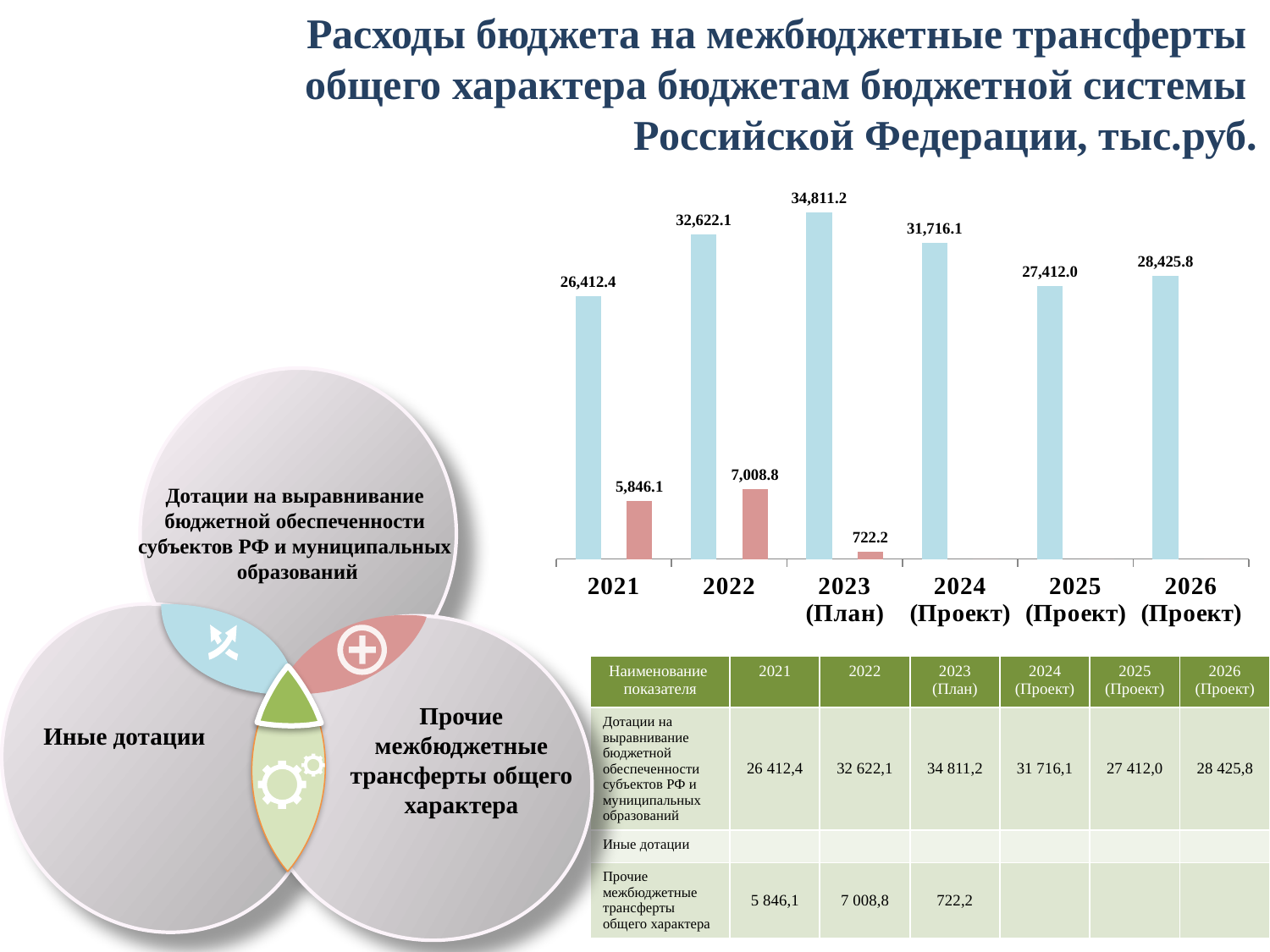
What is the difference between the pink bar values for 2022 and 2021? 1,162.7 What is the value of the pink bar for 2022? 7,008.8 What is the value of the pink bar for 2023 (План)? 722.2 What is the value of the light blue bar for 2023 (План)? 34,811.2 How many year categories are shown on the x axis of the chart? 6 In which year is the light blue bar the lowest? 2021 What is the value of the light blue bar for 2026 (Проект)? 28,425.8 Do the pink bar values rise or fall from 2022 to 2023 (План)? Fall Which is larger: the light blue bar for 2025 (Проект) or for 2026 (Проект)? 2026 (Проект) What is the difference between the light blue bar values for 2023 (План) and 2024 (Проект)? 3,095.1 What type of chart is shown on the slide? Bar chart In which year does the light blue bar reach its highest value? 2023 (План)